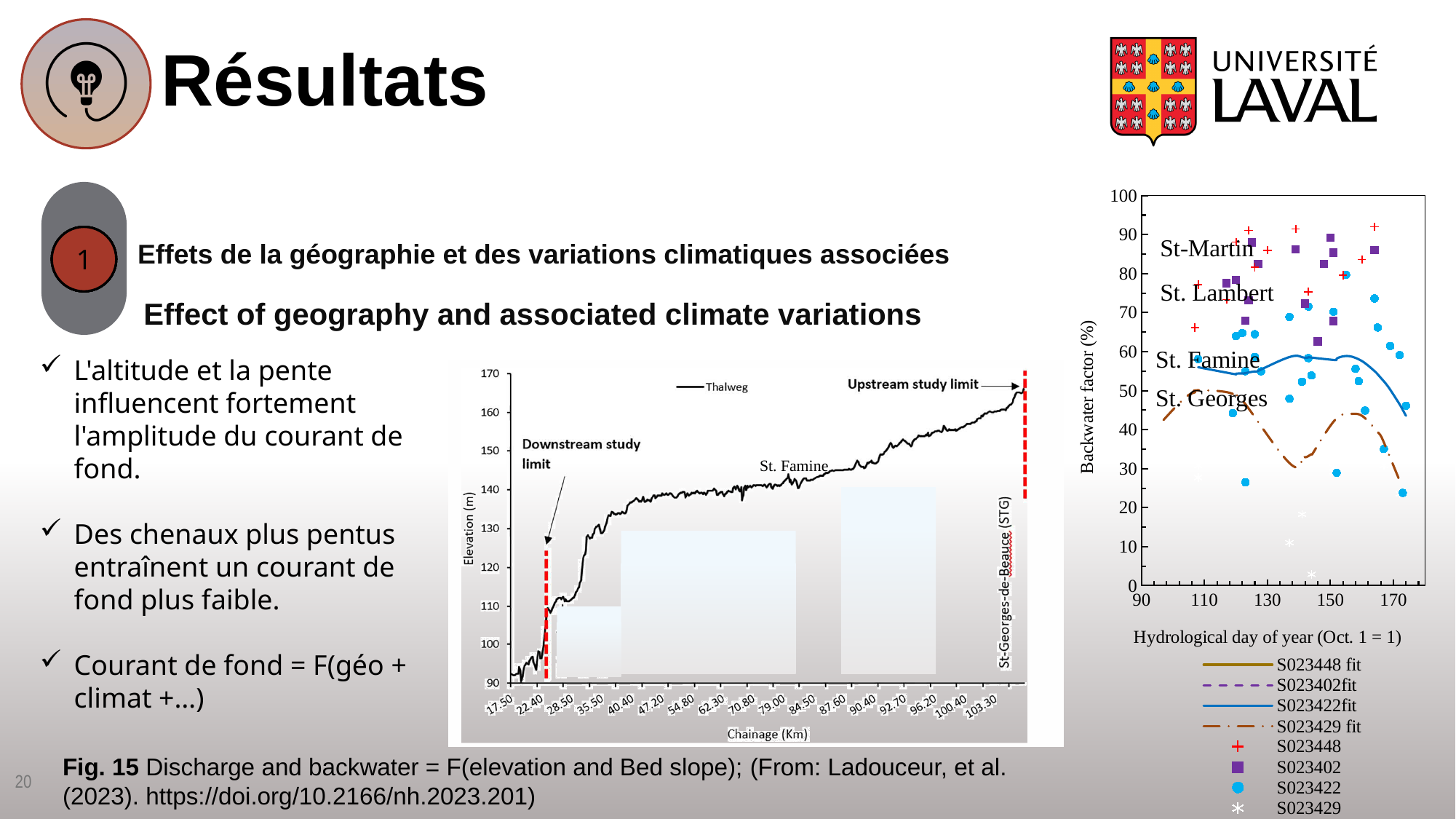
In the chart on the right, what kind of chart is it? scatter chart In the elevation chart in the middle of the slide, is the elevation at the Upstream study limit greater or less than 160? greater In the elevation chart in the middle of the slide, is the elevation at chainage 79.00 km greater or less than 130? greater In the elevation chart in the middle of the slide, what kind of chart is it? line chart In the elevation chart in the middle of the slide, is the elevation at the Downstream study limit greater or less than 120? less In the chart on the right, is the S023422fit line at hydrological day 150 greater or less than the S023429 fit line at the same day? greater In the elevation chart in the middle of the slide, what is the label of the y axis? Elevation (m) In the chart on the right, what is the label of the y axis? Backwater factor (%) In the chart on the right, how many entries does the legend list? 8 In the elevation chart in the middle of the slide, does the Thalweg elevation rise or fall as chainage increases? rise